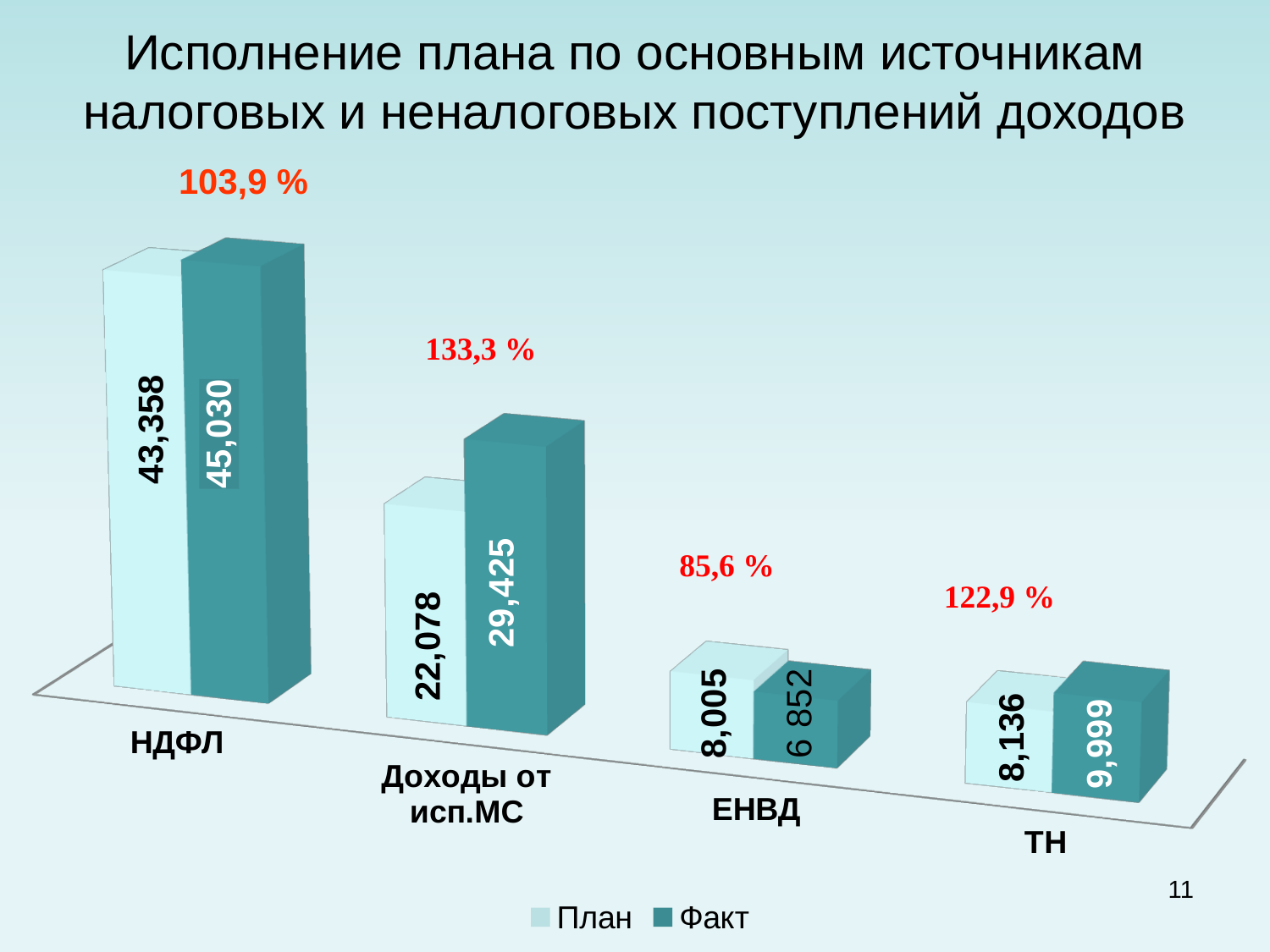
What is the Факт value for Доходы от исп.МС? 29,425 What is the План value for НДФЛ? 43,358 How many series does the legend list? 2 What is the План value for ТН? 8,136 What is the difference between the Факт and План values for Доходы от исп.МС? 7,347 For ЕНВД, which is larger: the План value or the Факт value? План Which category has the lowest План value? ЕНВД How many categories are shown on the x axis? 4 Which category has the highest Факт value? НДФЛ What kind of chart is shown on the slide? Bar chart What is the Факт value for ЕНВД? 6 852 What is the difference between the Факт and План values for НДФЛ? 1,672